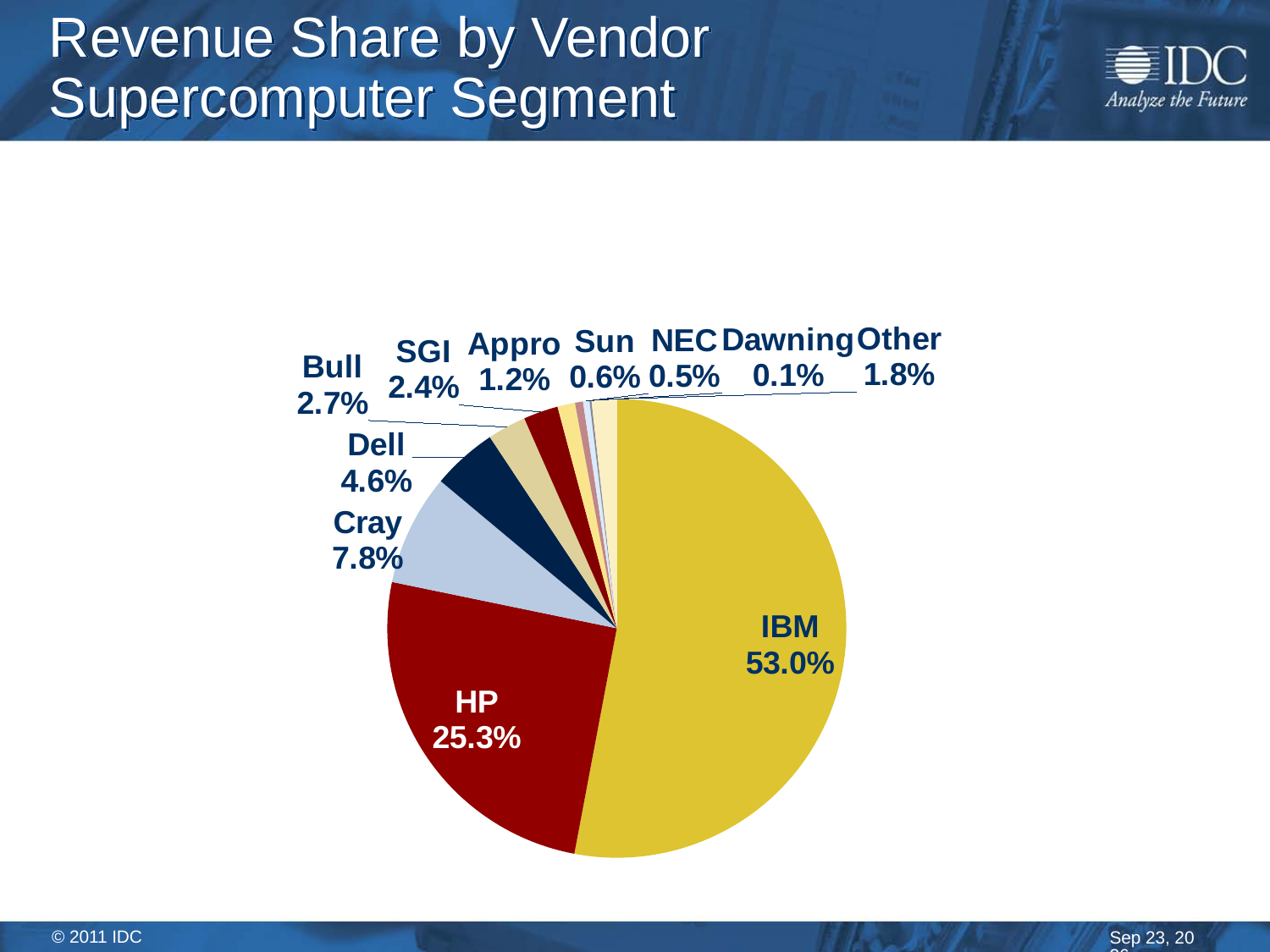
What is the difference between IBM's and HP's revenue shares? 27.7% What is IBM's revenue share in the supercomputer segment? 53.0% Which has a larger revenue share, Cray or Dell? Cray Which vendor has the smallest revenue share? Dawning What is Cray's revenue share? 7.8% Which vendor has the largest revenue share? IBM What type of chart is shown on the slide? pie chart What is the revenue share for Dell? 4.6% What is the title of the slide? Revenue Share by Vendor Supercomputer Segment What is the combined revenue share of Bull and SGI? 5.1% What is HP's revenue share? 25.3% How many slices does the pie chart have? 11